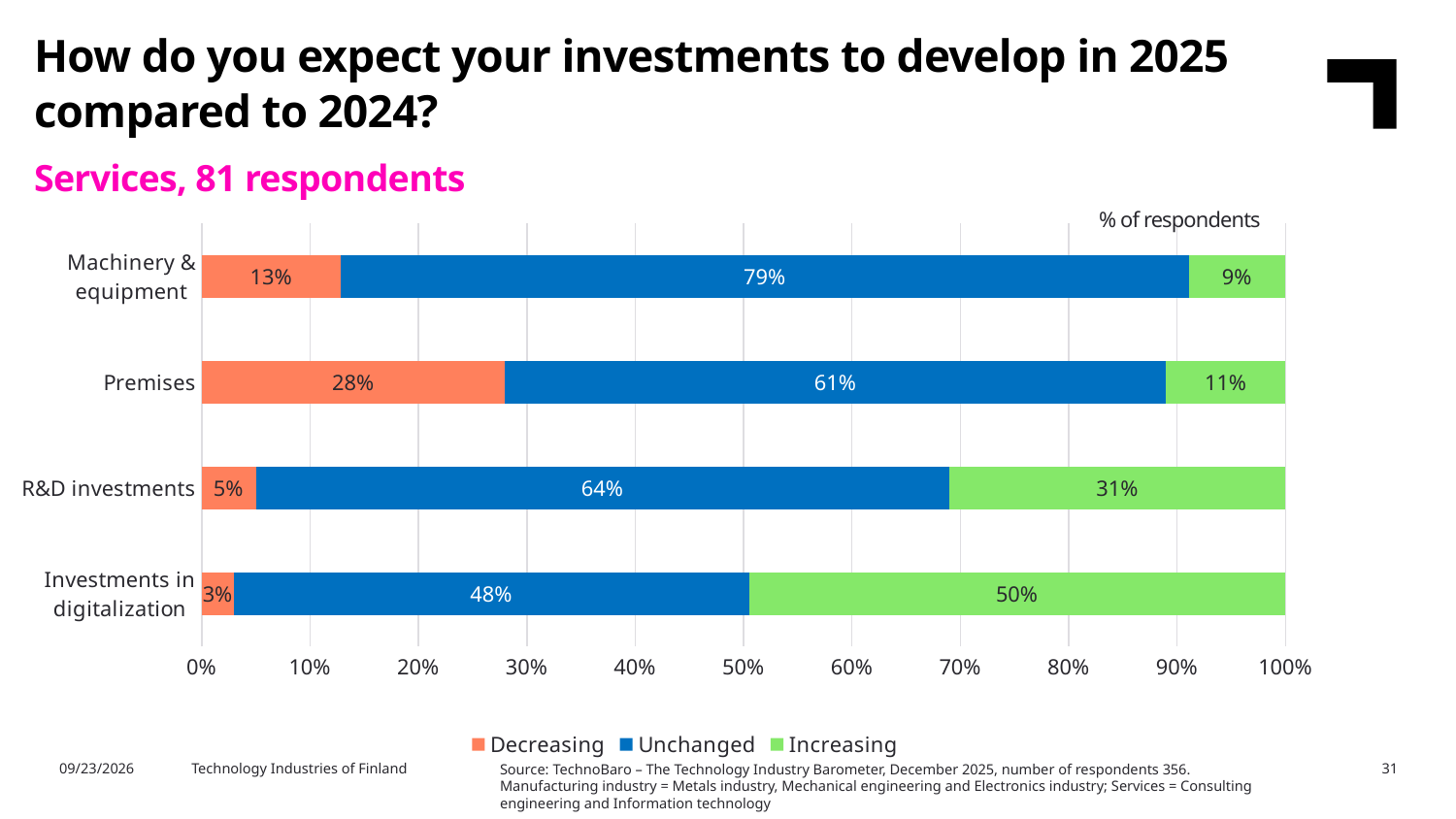
How many investment categories are shown on the chart? 4 Which is larger: the Decreasing share for Premises or the Decreasing share for Machinery & equipment? Premises Which category has the lowest share of respondents expecting Decreasing investments? Investments in digitalization What is the total of the three segments in the Premises bar? 100% What percentage of respondents expect Investments in digitalization to be Increasing? 50% What type of chart is shown on the slide? Stacked bar chart Which category has the highest share of respondents expecting Increasing investments? Investments in digitalization What percentage of respondents expect Premises investments to be Decreasing? 28% What is the difference between the Unchanged share for Machinery & equipment and the Unchanged share for Investments in digitalization? 31% What percentage of respondents expect Machinery & equipment investments to be Unchanged? 79% What percentage of respondents expect R&D investments to be Increasing? 31% How many series does the legend list? 3